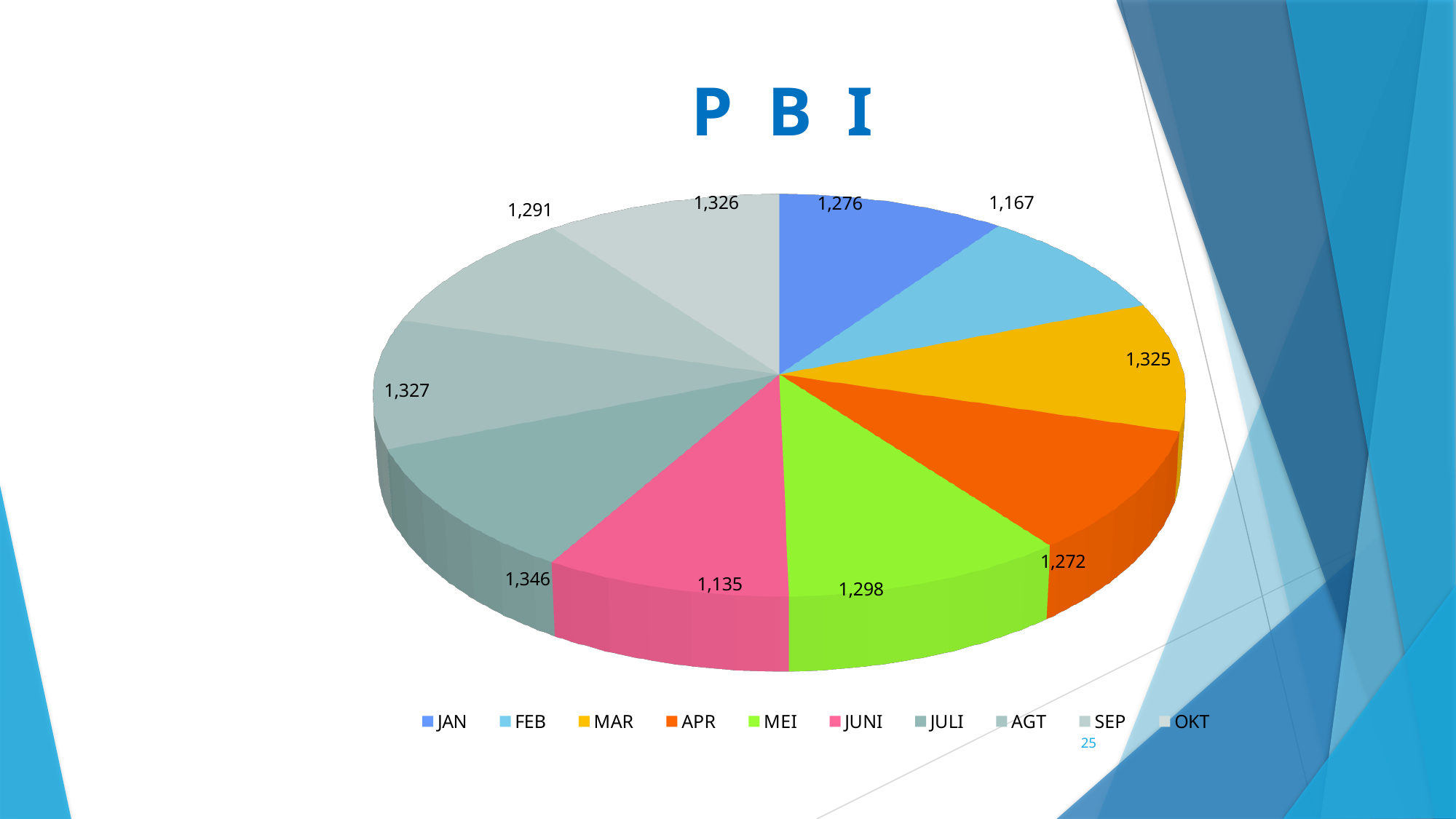
How many entries does the legend list? 10 What is the value for JUNI? 1,135 What is the value for AGT? 1,327 What is the value for JAN? 1,276 What is the difference between the values for JAN and FEB? 109 What is the title of the chart? P B I What is the value for FEB? 1,167 What type of chart is shown on the slide? Pie chart Which month has the highest value? JULI Which is larger, the value for JULI or the value for JUNI? JULI How many slices does the pie chart have? 10 Which month has the lowest value? JUNI